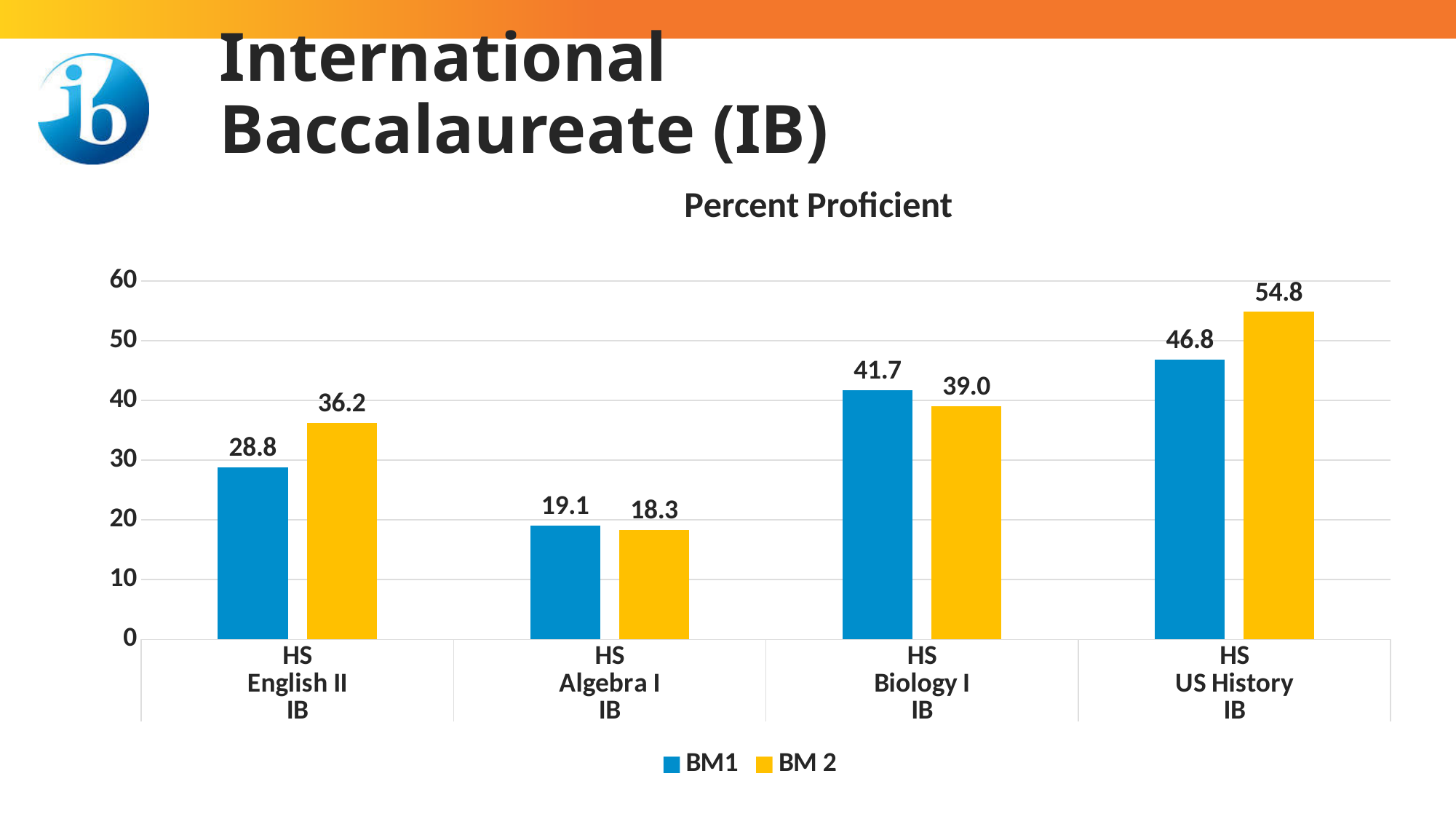
Is the BM1 value for HS Biology I IB greater or less than 40? greater How many categories are shown on the x axis? 4 For HS US History IB, which is larger, BM1 or BM 2? BM 2 What is the BM1 value for HS English II IB? 28.8 What kind of chart is shown on the slide? bar chart Which category has the highest BM 2 value? HS US History IB How many series does the legend list? 2 Which category has the lowest BM1 value? HS Algebra I IB What is the BM 2 value for HS US History IB? 54.8 What is the difference between the BM 2 and BM1 values for HS English II IB? 7.4 What is the BM 2 value for HS Biology I IB? 39.0 What is the difference between the BM1 and BM 2 values for HS Biology I IB? 2.7